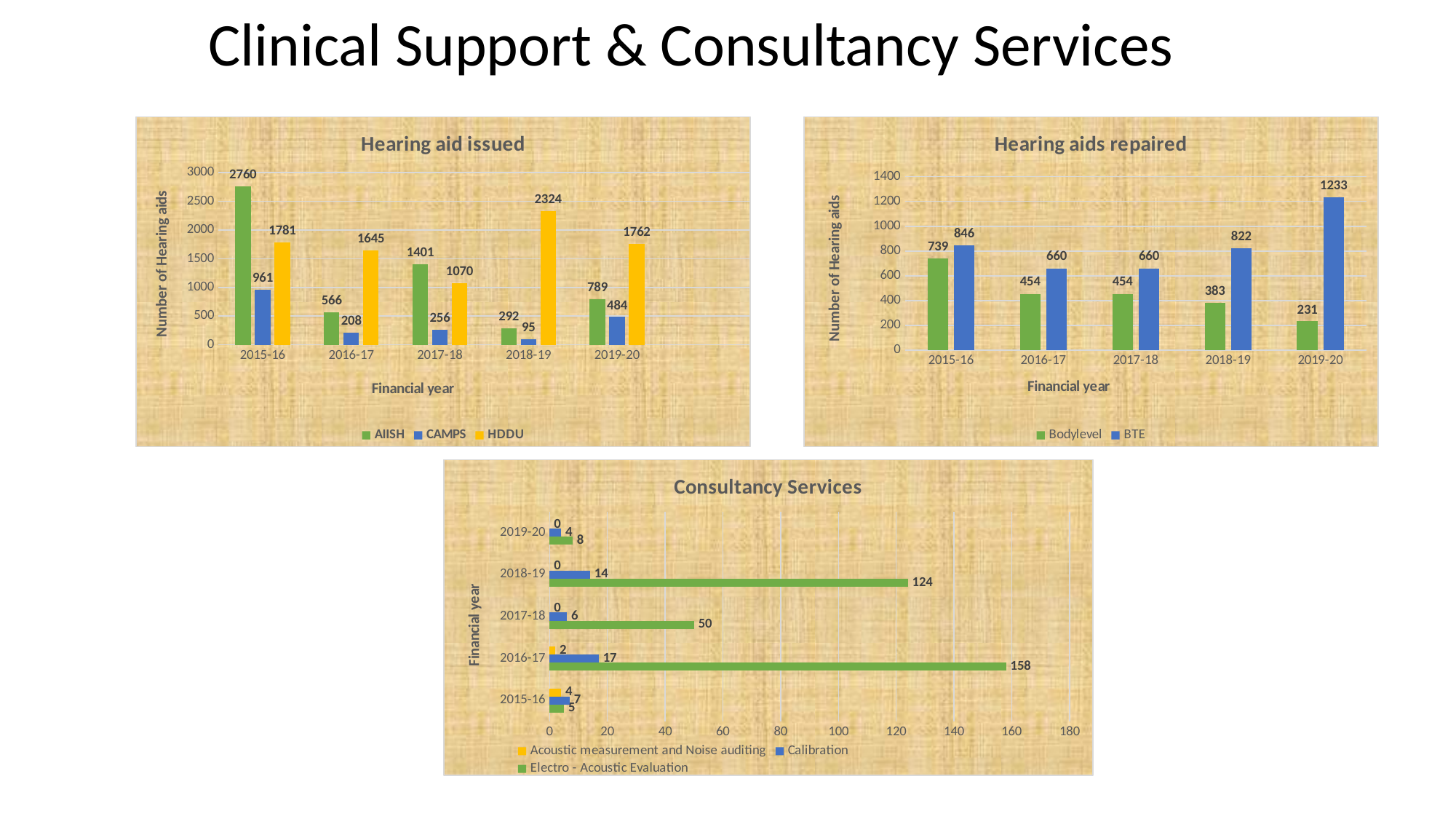
In the 'Hearing aid issued' chart, what is the AIISH value for 2015-16? 2760 In the 'Consultancy Services' chart, what is the Electro - Acoustic Evaluation value for 2016-17? 158 In the 'Hearing aid issued' chart, how many series does the legend list? 3 In the 'Hearing aids repaired' chart, how many financial years are shown on the x axis? 5 In the 'Hearing aids repaired' chart, is the Bodylevel value for 2015-16 or the BTE value for 2015-16 larger? BTE What kind of chart is 'Consultancy Services'? Bar chart In the 'Consultancy Services' chart, what is the Calibration value for 2018-19? 14 In the 'Hearing aids repaired' chart, which financial year has the highest Bodylevel value? 2015-16 In the 'Hearing aids repaired' chart, what is the BTE value for 2019-20? 1233 In the 'Hearing aid issued' chart, what is the difference between the HDDU and CAMPS values for 2019-20? 1278 In the 'Hearing aid issued' chart, what is the HDDU value for 2018-19? 2324 In the 'Hearing aid issued' chart, which financial year has the lowest CAMPS value? 2018-19